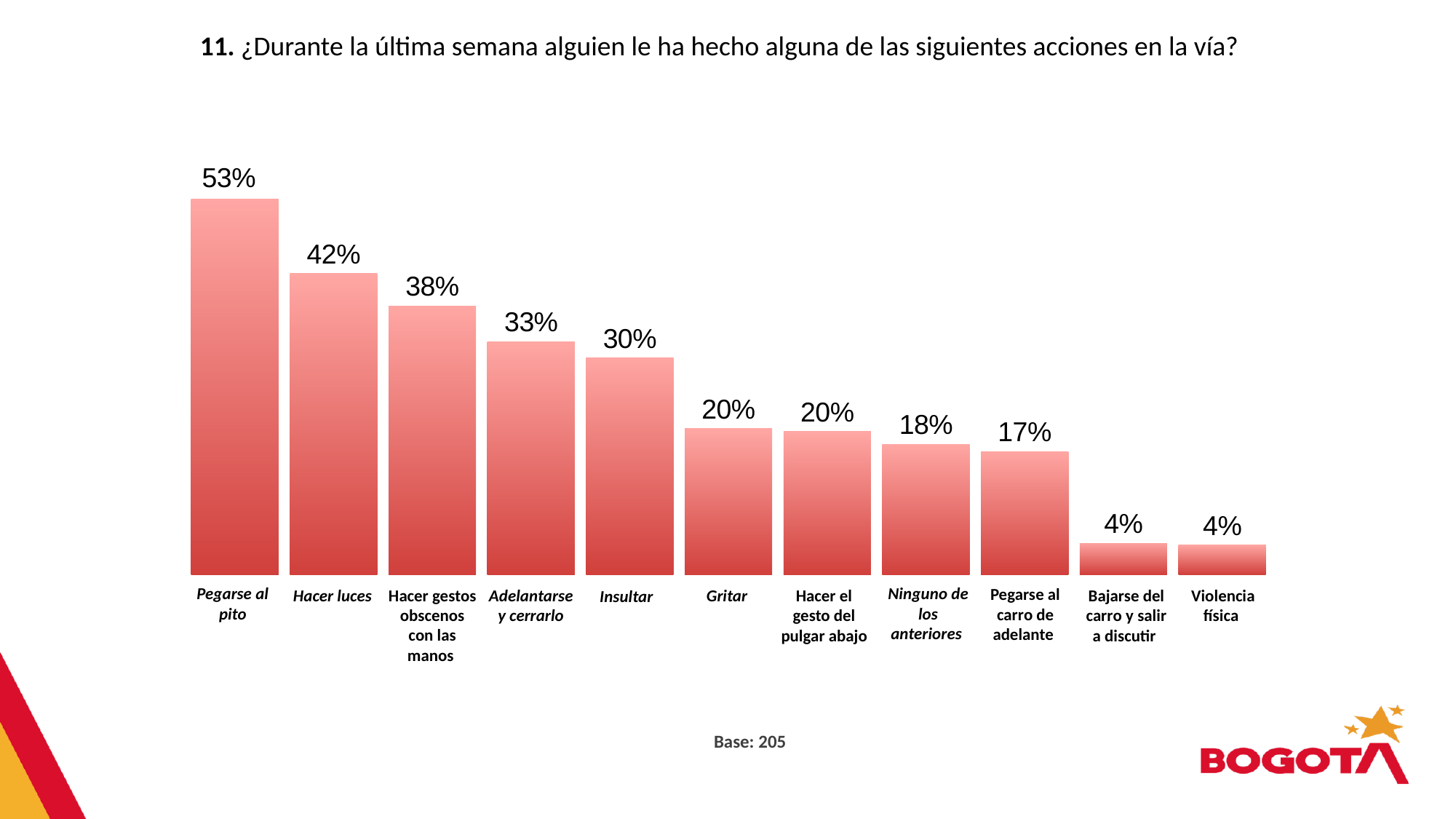
Which is larger, the value for "Gritar" or the value for "Pegarse al carro de adelante"? Gritar What is the value for "Pegarse al carro de adelante"? 17% What is the value for "Pegarse al pito"? 53% What is the value for "Ninguno de los anteriores"? 18% What is the difference between "Hacer luces" and "Hacer gestos obscenos con las manos"? 4% What kind of chart is shown on the slide? Bar chart What is the difference between "Pegarse al pito" and "Adelantarse y cerrarlo"? 20% Which category has the highest value? Pegarse al pito Do the values rise or fall from left to right across the categories? Fall What is the value for "Insultar"? 30% What is the base (number of respondents) stated below the chart? 205 How many categories are shown in the chart? 11